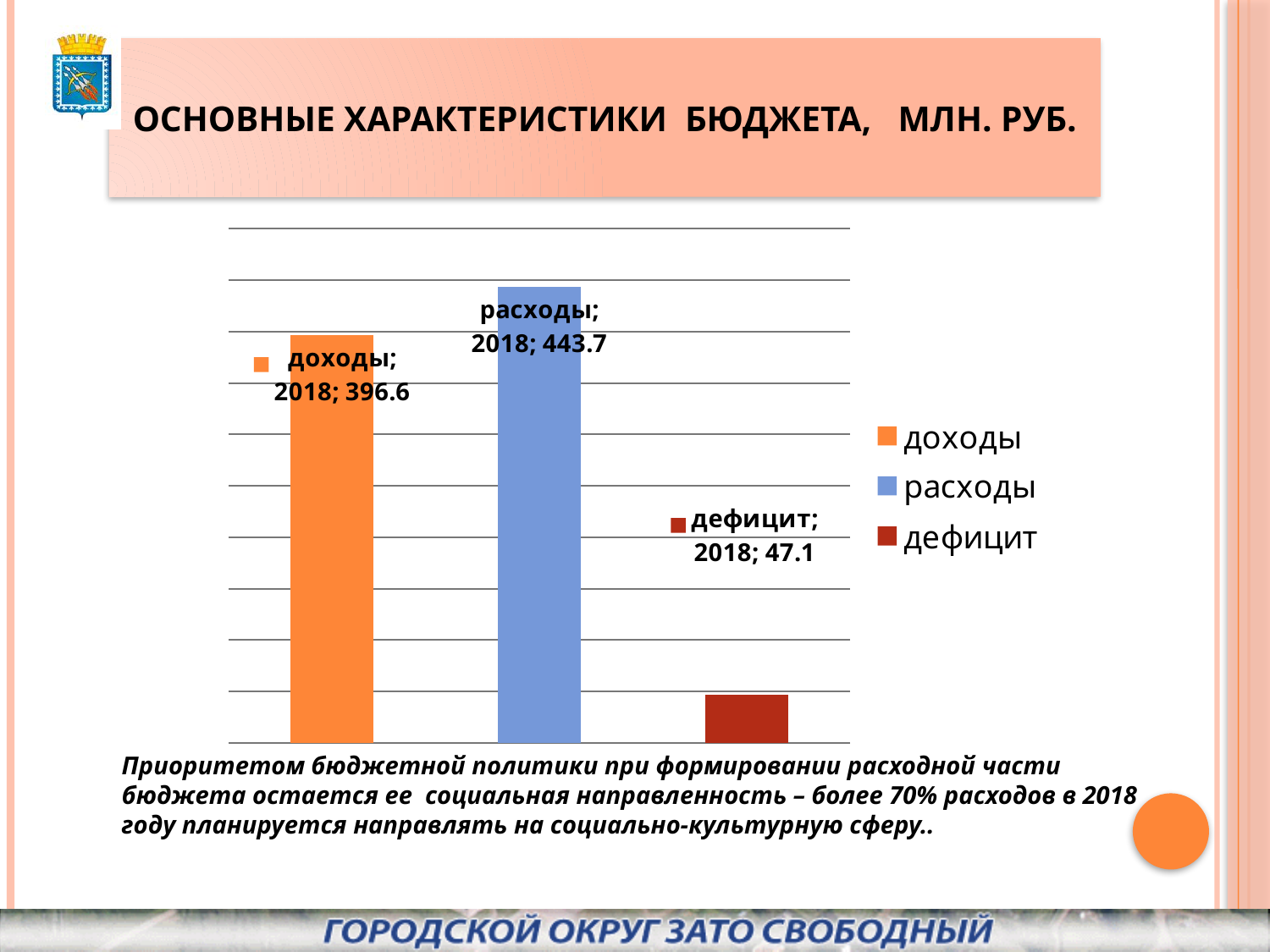
What kind of chart is shown on the slide? bar chart What is the value for расходы in 2018? 443.7 What colour is the bar for дефицит? dark red What is the value for доходы in 2018? 396.6 What is the difference between доходы and дефицит? 349.5 What is the value for дефицит in 2018? 47.1 Which series has the lowest value? дефицит What is the difference between расходы and доходы? 47.1 Which is larger, доходы or расходы? расходы Which series has the highest value? расходы How many bars are plotted on the chart? 3 How many series does the legend list? 3